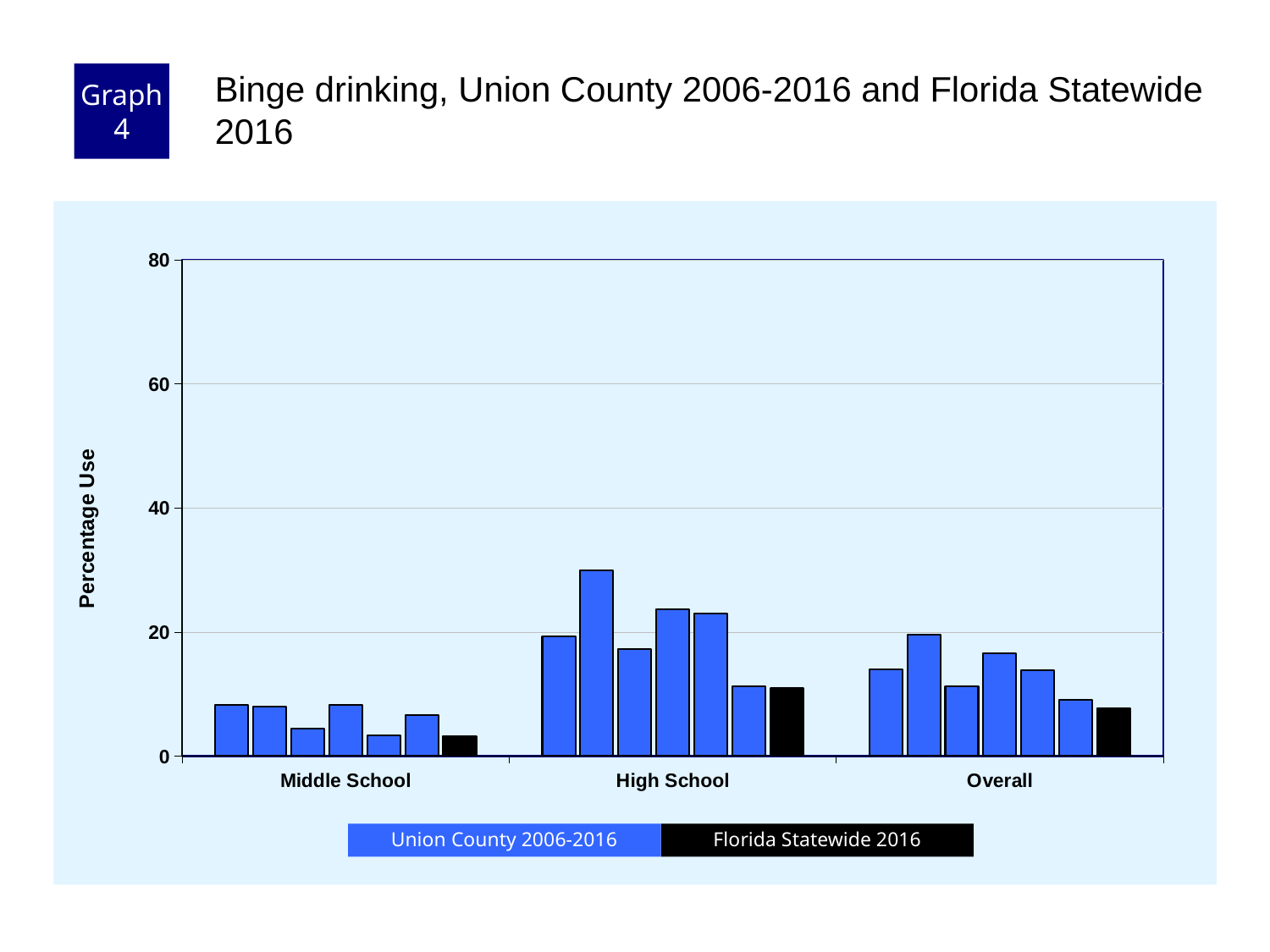
What kind of chart is shown on the slide? Bar chart Are all the Union County 2006-2016 bars for Middle School greater or less than 20? less Is the Florida Statewide 2016 value for Middle School greater or less than 20? less Which is larger, the Florida Statewide 2016 value for High School or for Middle School? High School Is the Florida Statewide 2016 value for High School greater or less than 20? less How many series does the legend list? 2 Which category contains the tallest bar in the chart? High School How many categories are shown along the x axis? 3 What is the label on the vertical axis? Percentage Use Which colour represents Florida Statewide 2016 in the legend? Black